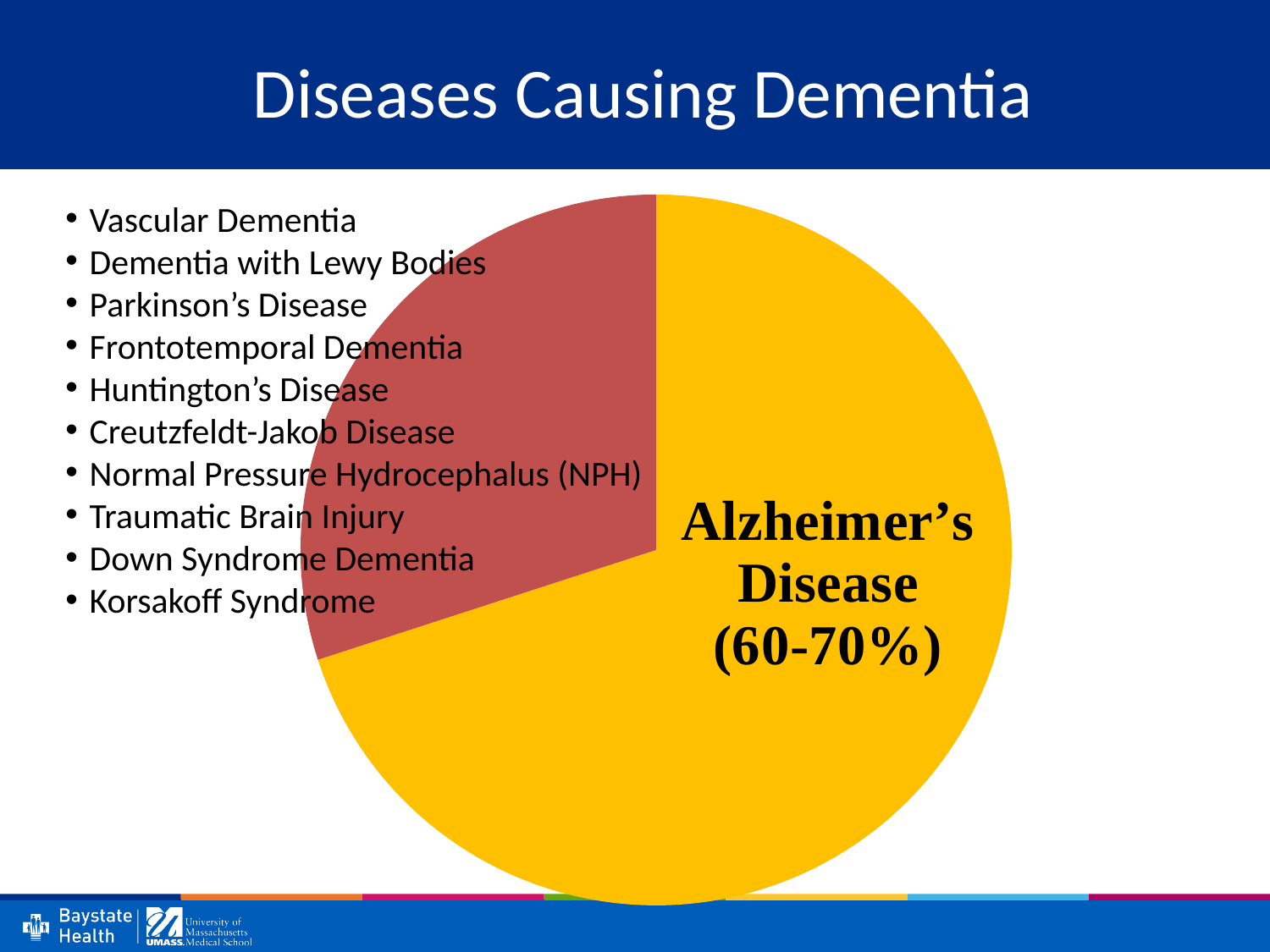
How many slices does the pie chart have? 2 What is the title of the slide containing the pie chart? Diseases Causing Dementia Which slice of the pie chart is the largest? Alzheimer's Disease What share of the pie is labelled for Alzheimer's Disease? 60-70% Which slice is larger, the yellow slice or the red slice? the yellow slice Is the Alzheimer's Disease slice greater or less than half of the pie? greater What colour is the Alzheimer's Disease slice in the pie chart? yellow What kind of chart is shown on the slide? pie chart